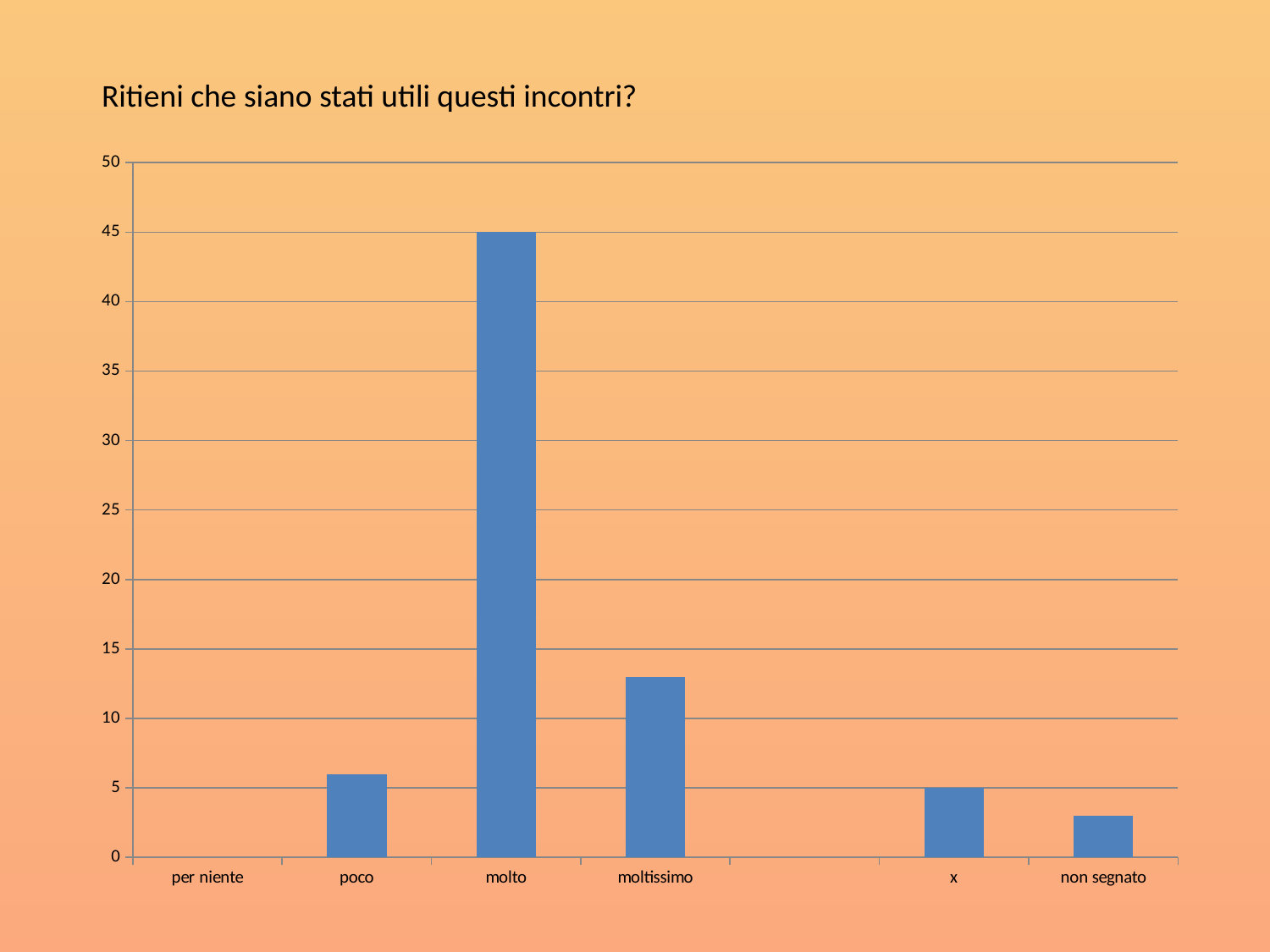
Is the value for "non segnato" greater or less than 5? less How many bars are visible in the chart? 5 Which category has the highest value? molto Which is larger, the value for "x" or the value for "non segnato"? x Is the value for "moltissimo" greater or less than 10? greater What is the value for "molto"? 45 Is the value for "poco" greater or less than 10? less Which is larger, the value for "poco" or the value for "moltissimo"? moltissimo What is the value for "x"? 5 What is the title of the chart? Ritieni che siano stati utili questi incontri? What kind of chart is shown on the slide? bar chart What is the difference between the value for "molto" and the value for "x"? 40